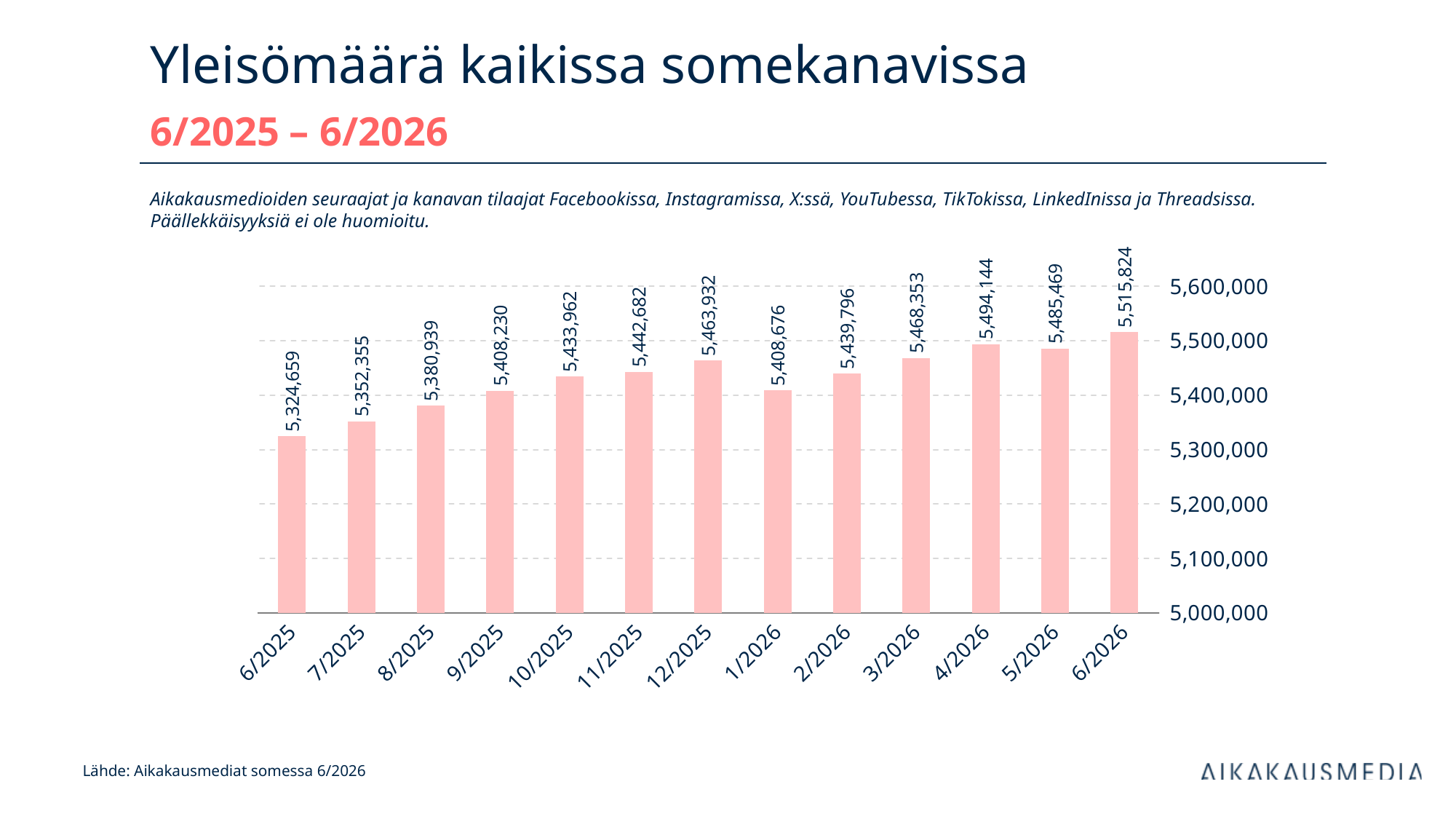
Which month has the highest value? 6/2026 How many months are shown on the x axis? 13 What is the difference between the values for 12/2025 and 1/2026? 55,256 What kind of chart is shown on the slide? bar chart What is the value for 6/2025? 5,324,659 Which month has the lowest value? 6/2025 What is the difference between the values for 6/2026 and 6/2025? 191,165 What is the value for 1/2026? 5,408,676 Is the value for 9/2025 greater or less than 5,400,000? greater Do the values generally rise or fall from 6/2025 to 6/2026? rise Which is larger, the value for 12/2025 or the value for 1/2026? 12/2025 What is the value for 6/2026? 5,515,824